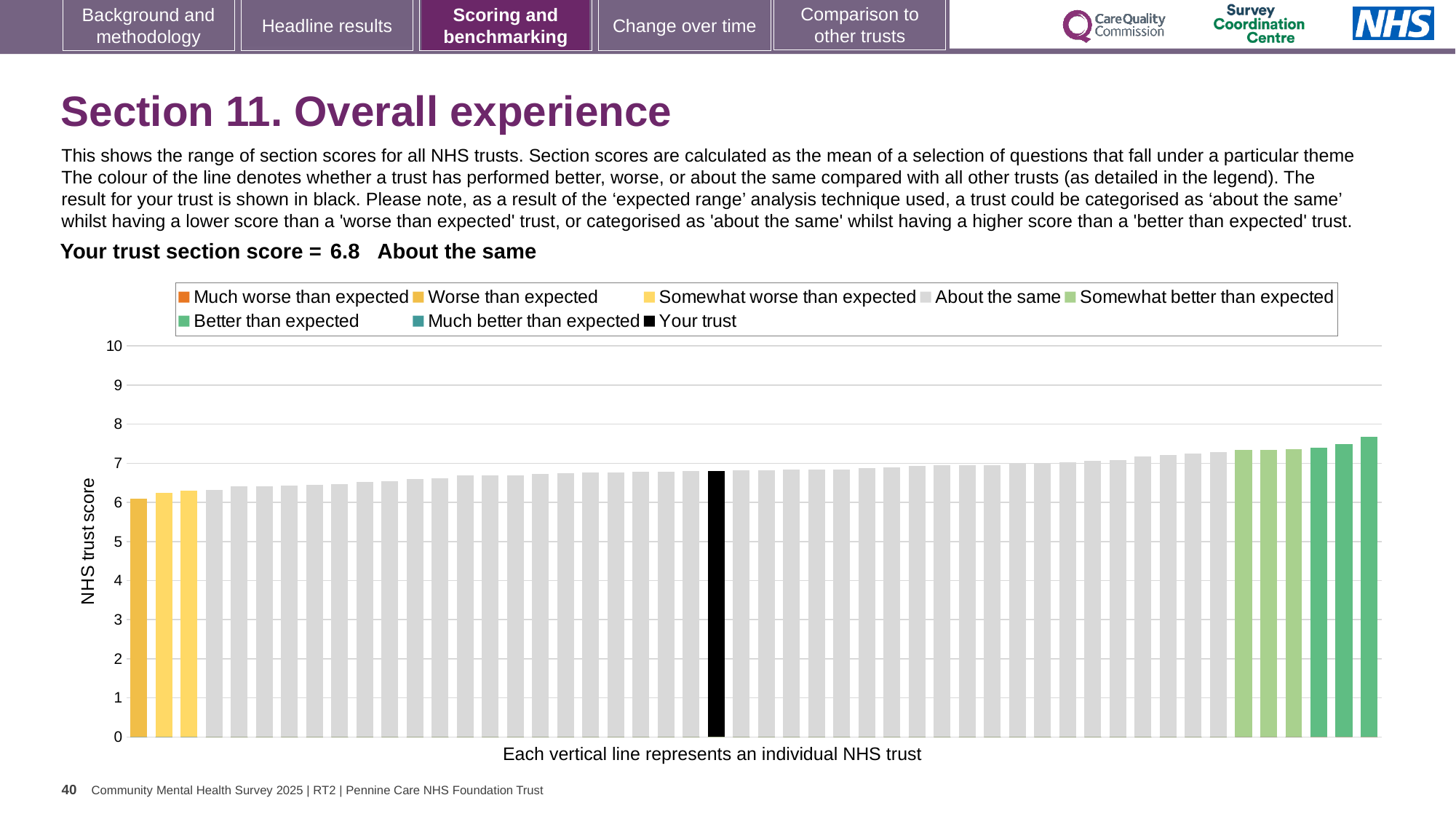
How many entries does the chart legend list? 8 What is the label on the y axis of the chart? NHS trust score How many bars are coloured as 'Better than expected' (dark green)? 3 Is the value of the lowest bar in the chart greater or less than 5? greater Is the value of the highest bar in the chart greater or less than 8? less How many bars are coloured as 'Somewhat worse than expected' (light yellow)? 2 Do the bar values rise or fall from left to right along the x axis? rise What is the section score for your trust shown on the slide? 6.8 Which category is your trust placed in for Section 11 Overall experience? About the same What is the highest value shown on the y axis? 10 Is the value for your trust (the black bar) greater or less than 5? greater What kind of chart is shown on the slide? Bar chart